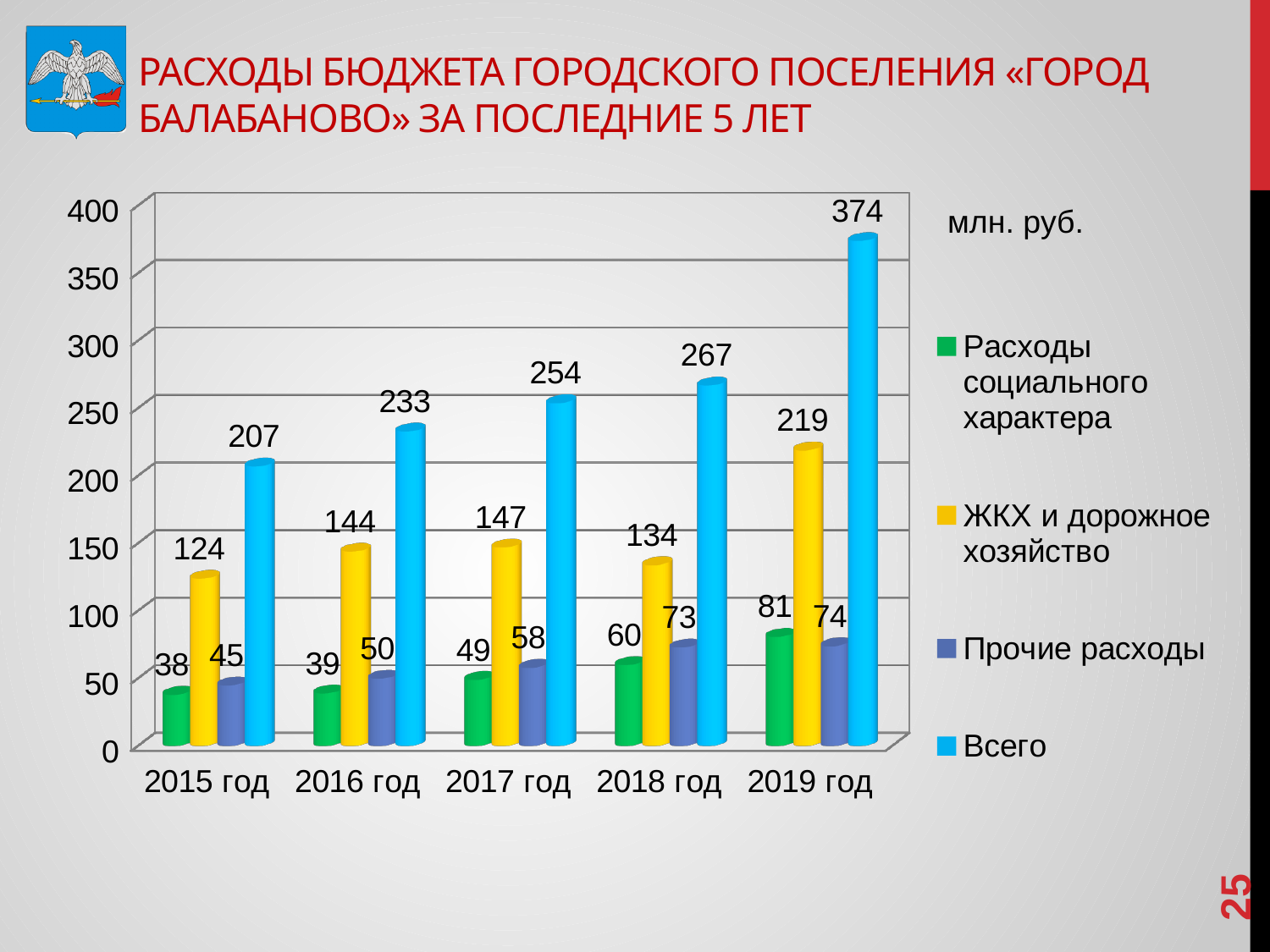
Does «Всего» rise or fall from 2015 год to 2019 год? rise What is the value of «Прочие расходы» for 2018 год? 73 What is the value of «Всего» for 2019 год? 374 What is the value of «Расходы социального характера» for 2015 год? 38 What kind of chart is shown on the slide? bar chart What is the value of «ЖКХ и дорожное хозяйство» for 2017 год? 147 In which year is «ЖКХ и дорожное хозяйство» the lowest? 2015 год How many series does the legend list? 4 Which is larger: «Прочие расходы» in 2019 год or «Расходы социального характера» in 2019 год? Расходы социального характера How many years are shown on the x axis? 5 What is the difference between «Всего» in 2019 год and 2018 год? 107 In which year is «Всего» the highest? 2019 год